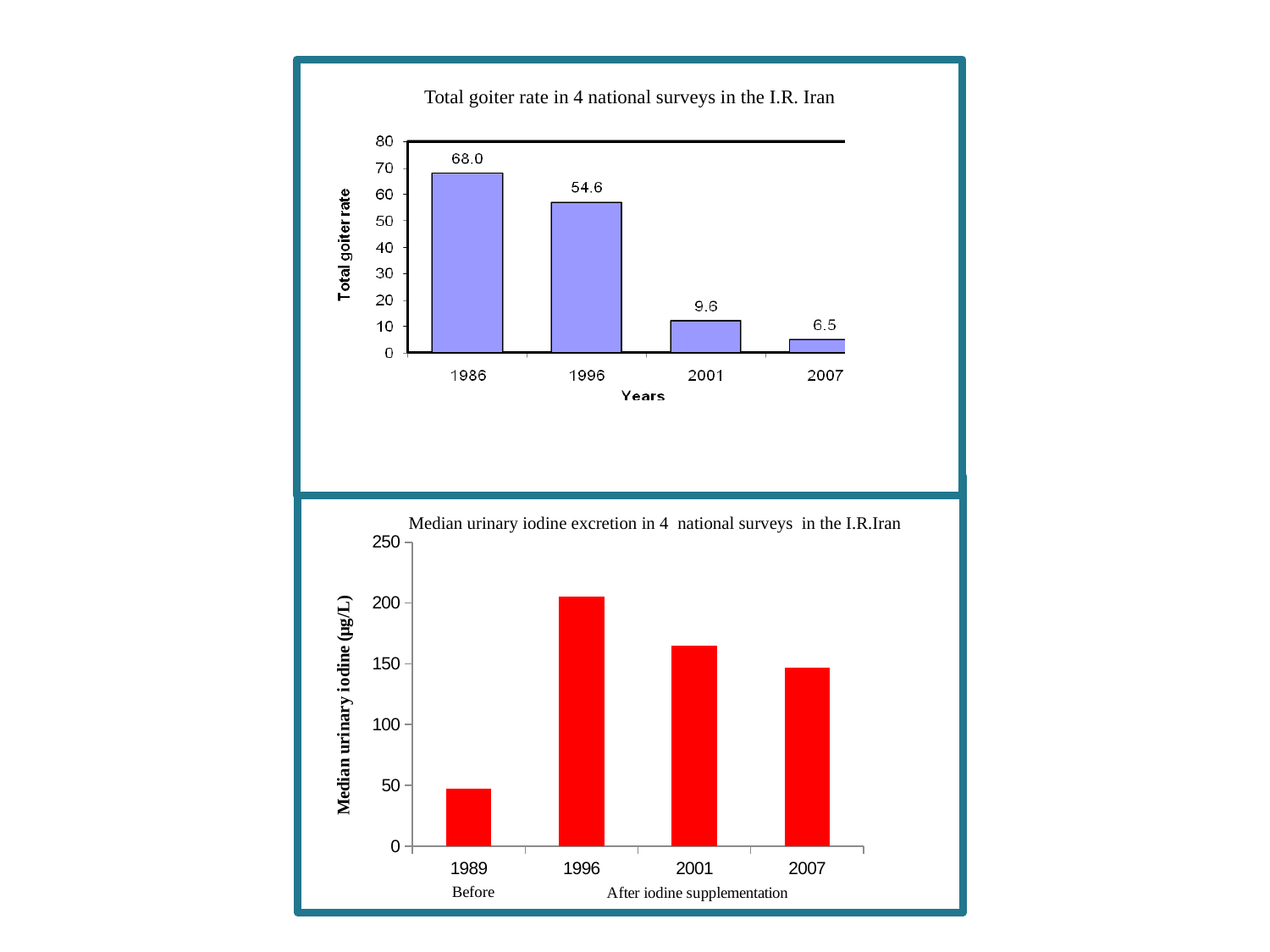
In the 'Median urinary iodine excretion in 4 national surveys in the I.R.Iran' chart, which year has the lowest median urinary iodine? 1989 In the 'Total goiter rate in 4 national surveys in the I.R. Iran' chart, what is the total goiter rate for 1986? 68.0 In the 'Total goiter rate in 4 national surveys in the I.R. Iran' chart, what is the difference between the total goiter rate in 1986 and in 1996? 13.4 In the 'Total goiter rate in 4 national surveys in the I.R. Iran' chart, which year has the lowest total goiter rate? 2007 In the 'Total goiter rate in 4 national surveys in the I.R. Iran' chart, which year has the highest total goiter rate? 1986 In the 'Median urinary iodine excretion in 4 national surveys in the I.R.Iran' chart, is the value for 1996 greater or less than 200? greater In the 'Median urinary iodine excretion in 4 national surveys in the I.R.Iran' chart, which year has the highest median urinary iodine? 1996 In the 'Median urinary iodine excretion in 4 national surveys in the I.R.Iran' chart, is the value for 1989 greater or less than 50? less In the 'Total goiter rate in 4 national surveys in the I.R. Iran' chart, do the values rise or fall from 1986 to 2007? fall In the 'Total goiter rate in 4 national surveys in the I.R. Iran' chart, how many years are shown on the x axis? 4 What type of chart is the 'Median urinary iodine excretion in 4 national surveys in the I.R.Iran' chart? bar chart In the 'Total goiter rate in 4 national surveys in the I.R. Iran' chart, what is the total goiter rate for 2007? 6.5